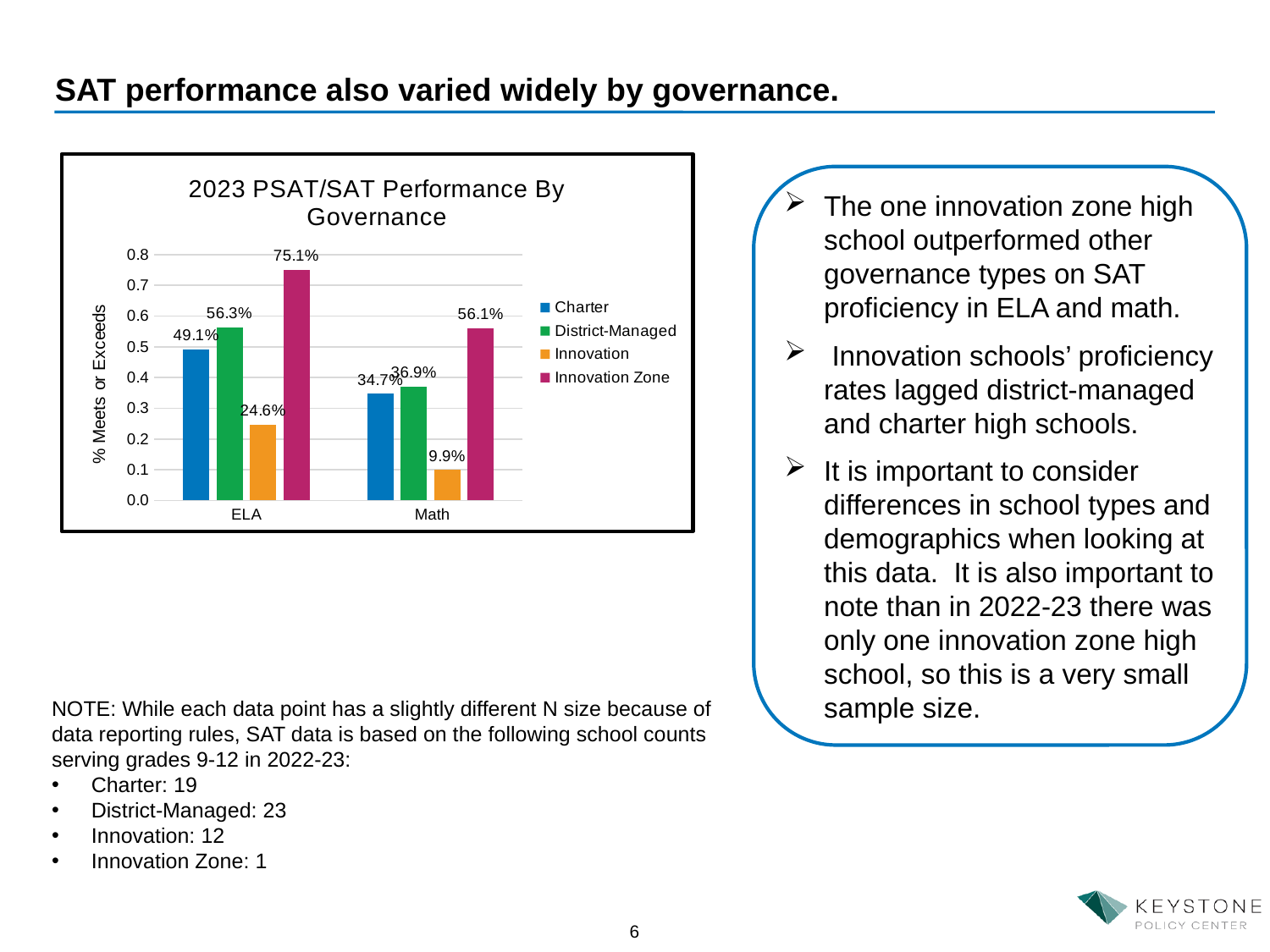
Which governance type has the highest value for Math? Innovation Zone What is the District-Managed value for Math? 36.9% What is the Innovation value for Math? 9.9% What is the title of the chart? 2023 PSAT/SAT Performance By Governance What kind of chart is shown on the slide? Bar chart Which governance type has the lowest value for ELA? Innovation What is the difference between the Innovation Zone and Charter values for ELA? 26.0% What is the Innovation Zone value for ELA? 75.1% How many series does the legend list? 4 What is the difference between the District-Managed and Innovation values for Math? 27.0% What is the Charter value for ELA? 49.1% Which is larger for ELA, the Charter value or the District-Managed value? District-Managed